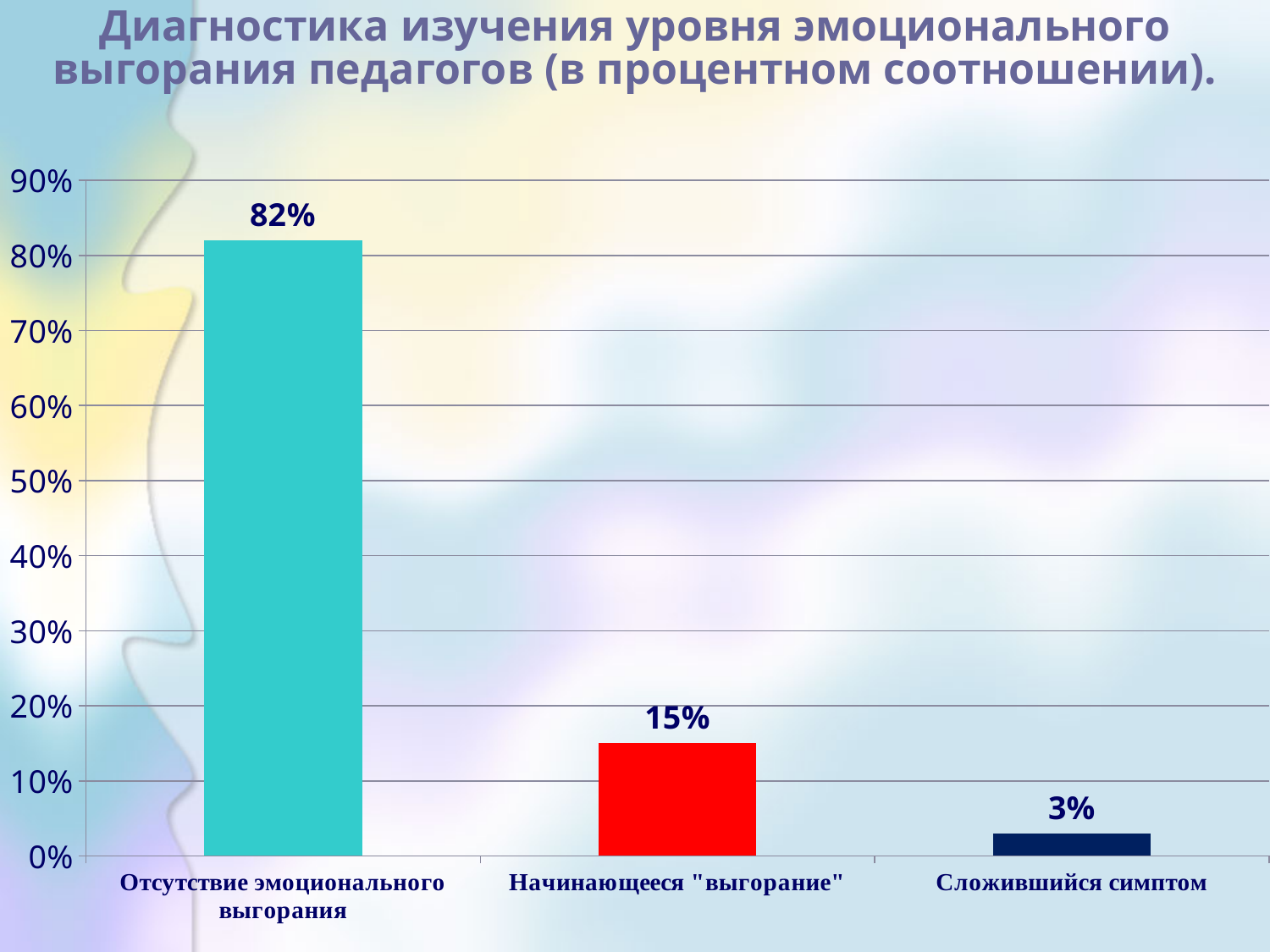
What is the value for "Отсутствие эмоционального выгорания"? 82% Which category has the lowest value? Сложившийся симптом Do the values rise or fall from left to right along the x axis? fall What is the value for "Сложившийся симптом"? 3% What is the value for "Начинающееся "выгорание""? 15% What is the difference between the values for "Начинающееся "выгорание"" and "Сложившийся симптом"? 12% Which is larger: the value for "Начинающееся "выгорание"" or for "Сложившийся симптом"? Начинающееся "выгорание" Is the value for "Отсутствие эмоционального выгорания" greater or less than 80%? greater What is the difference between the values for "Отсутствие эмоционального выгорания" and "Начинающееся "выгорание""? 67% How many categories are shown on the chart? 3 Which category has the highest value? Отсутствие эмоционального выгорания What kind of chart is shown on the slide? bar chart